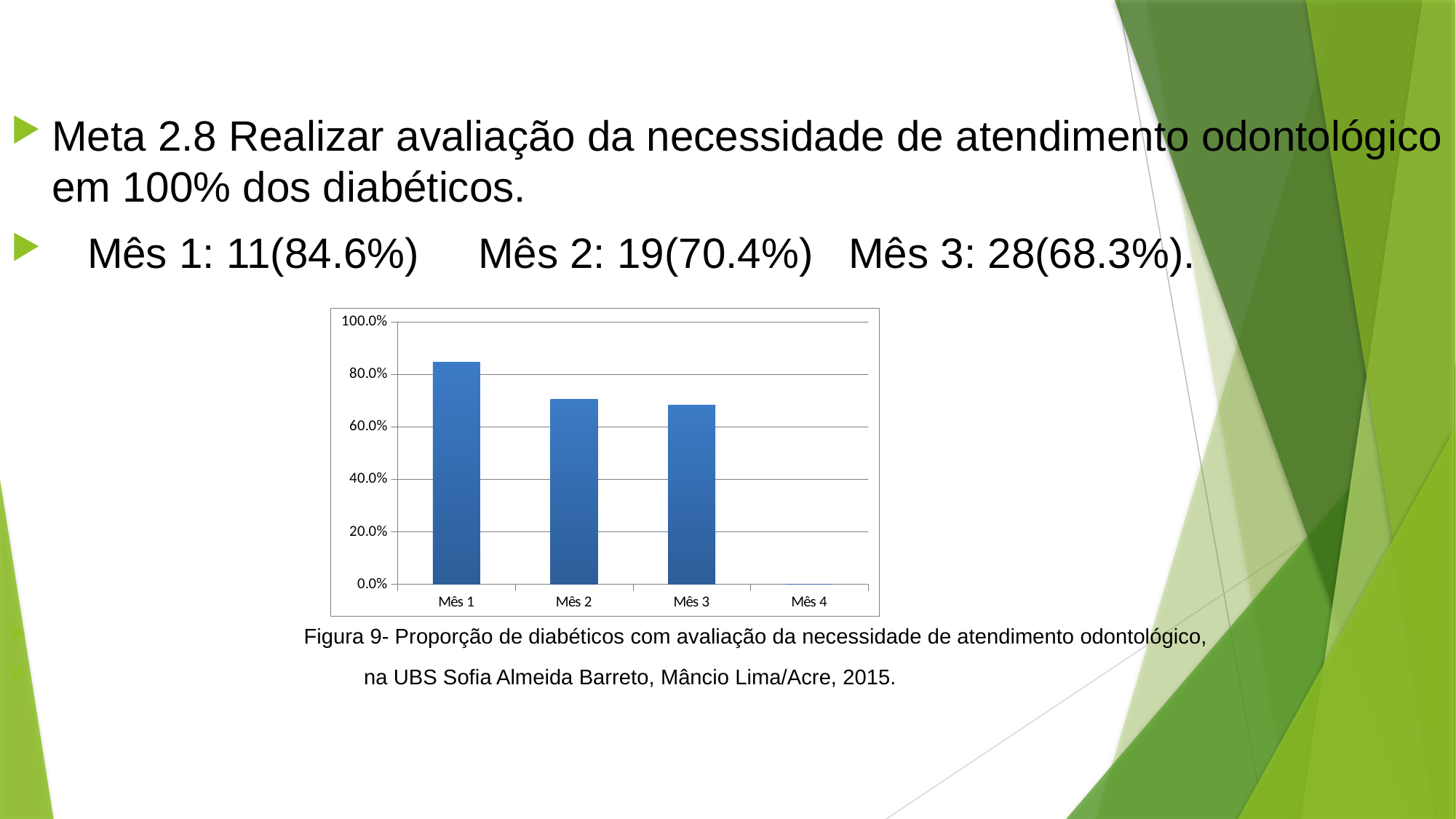
Is the value for Mês 3 greater or less than 80.0%? less Which month has the highest proportion in the chart? Mês 1 According to the slide, what is the proportion for Mês 2? 70.4% Which is larger, the value for Mês 1 or the value for Mês 3? Mês 1 Is the value for Mês 1 greater or less than 80.0%? greater What is the difference in percentage points between Mês 1 (84.6%) and Mês 2 (70.4%)? 14.2 percentage points Is the value for Mês 2 greater or less than 60.0%? greater Do the values rise or fall from Mês 1 to Mês 3? Fall How many month categories are shown on the x axis of the chart? 4 According to the slide, what is the proportion for Mês 1? 84.6% According to the slide, what is the proportion for Mês 3? 68.3% What type of chart is shown on the slide? Bar chart